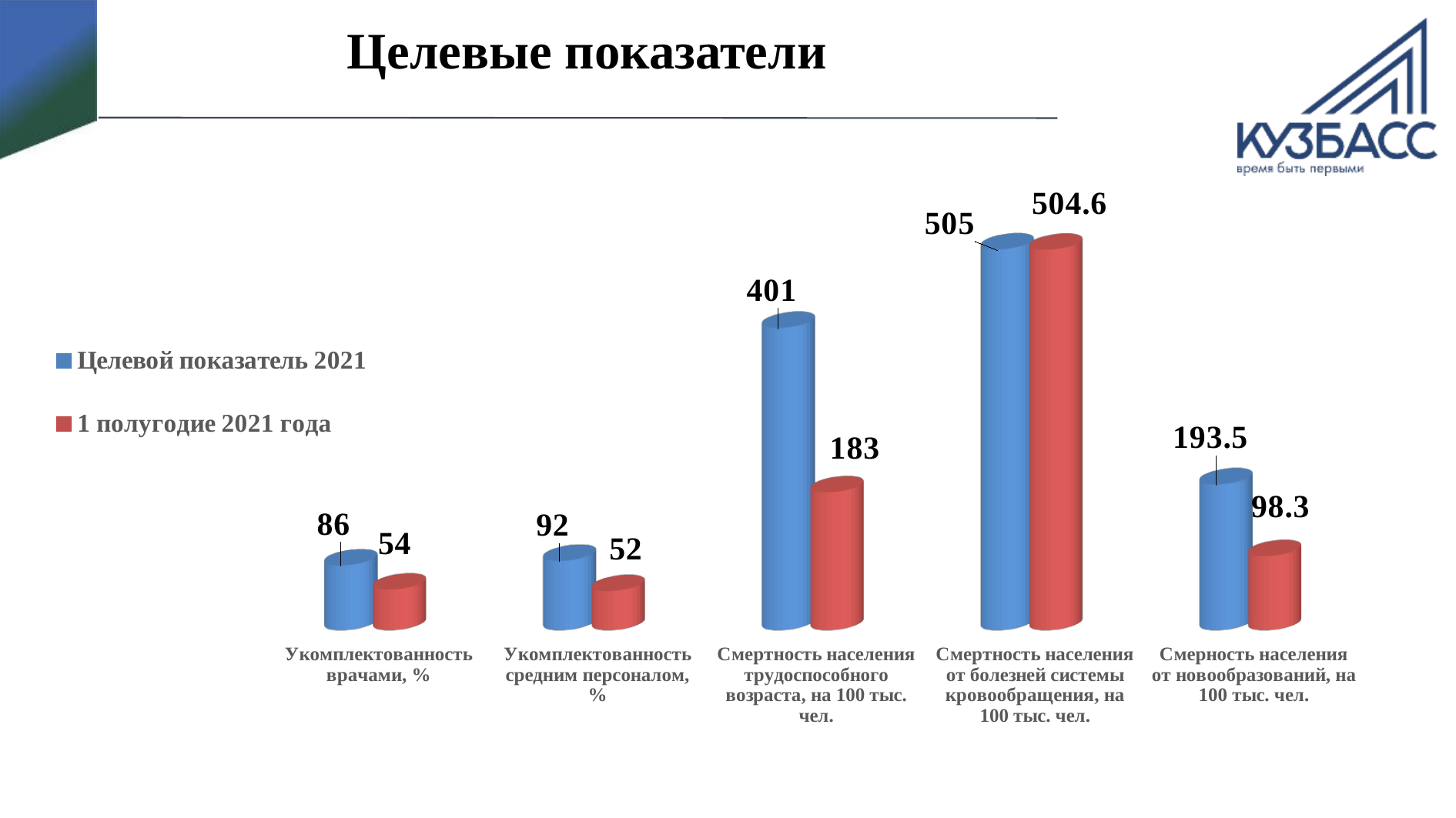
What is the value of "Целевой показатель 2021" for "Смерность населения от новообразований, на 100 тыс. чел."? 193.5 How many categories are shown on the x axis of the chart? 5 Which is larger for "Смерность населения от новообразований, на 100 тыс. чел.": "Целевой показатель 2021" or "1 полугодие 2021 года"? Целевой показатель 2021 Which category has the lowest value for "1 полугодие 2021 года"? Укомплектованность средним персоналом, % What is the value of "1 полугодие 2021 года" for "Смертность населения от болезней системы кровообращения, на 100 тыс. чел."? 504.6 What is the value of "Целевой показатель 2021" for "Укомплектованность врачами, %"? 86 What is the difference between "Целевой показатель 2021" and "1 полугодие 2021 года" for "Укомплектованность врачами, %"? 32 What is the value of "1 полугодие 2021 года" for "Смертность населения трудоспособного возраста, на 100 тыс. чел."? 183 What type of chart is shown on the slide? Bar chart How many series does the legend list? 2 What is the difference between "Целевой показатель 2021" and "1 полугодие 2021 года" for "Смертность населения трудоспособного возраста, на 100 тыс. чел."? 218 Which category has the highest value for "Целевой показатель 2021"? Смертность населения от болезней системы кровообращения, на 100 тыс. чел.